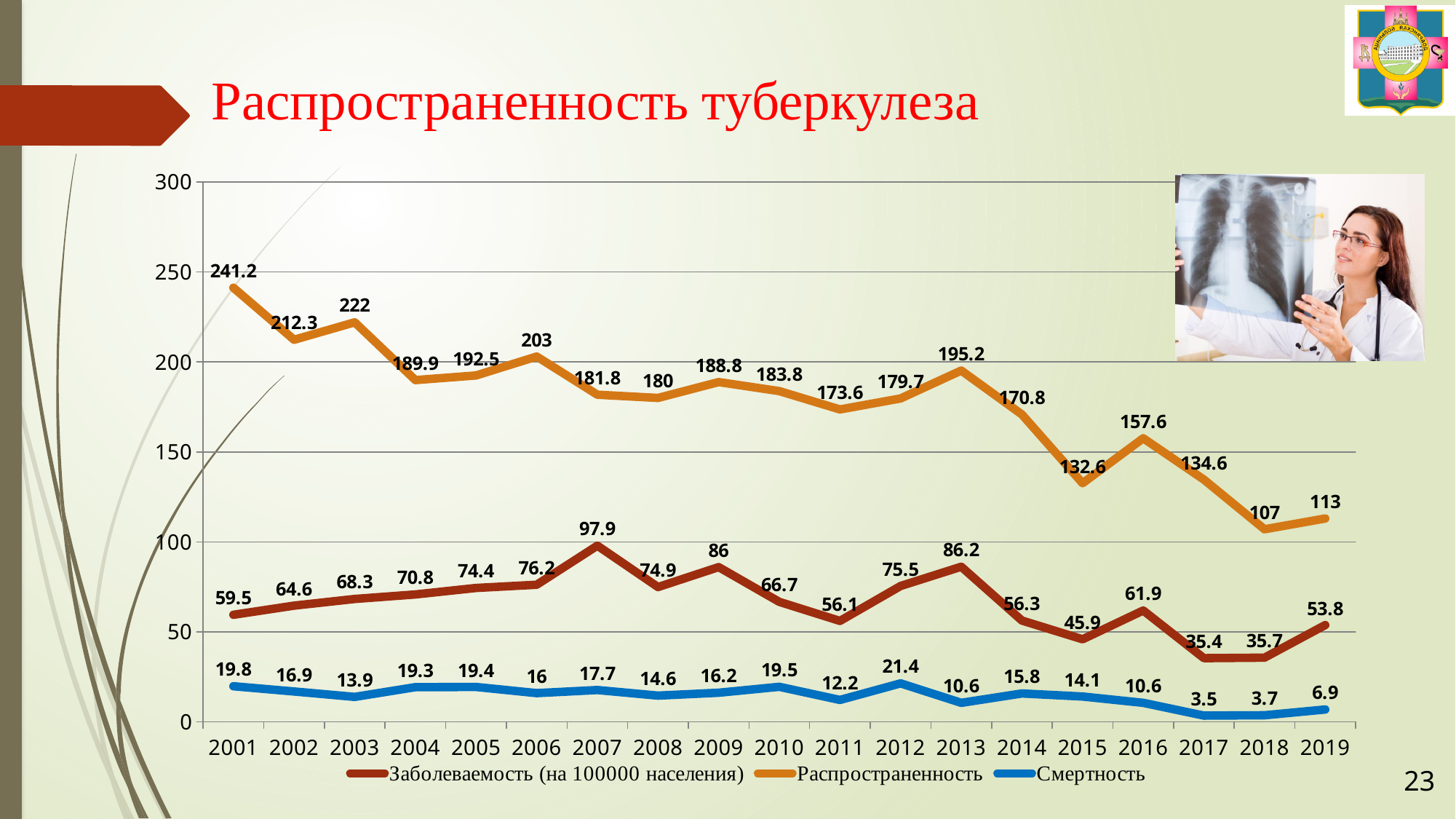
How many series does the legend list? 3 What is the value of Заболеваемость (на 100000 населения) in 2007? 97.9 What is the difference between Распространенность in 2001 and in 2019? 128.2 How many years are plotted along the x axis? 19 Overall, does Распространенность rise or fall from 2001 to 2019? fall In which year is Распространенность at its lowest? 2018 What kind of chart is shown on the slide? line chart What is the value of Смертность in 2019? 6.9 What is the value of Распространенность in 2001? 241.2 Which is larger: Заболеваемость in 2013 or Заболеваемость in 2014? 2013 What is the title of the slide? Распространенность туберкулеза In which year is Смертность at its highest? 2012